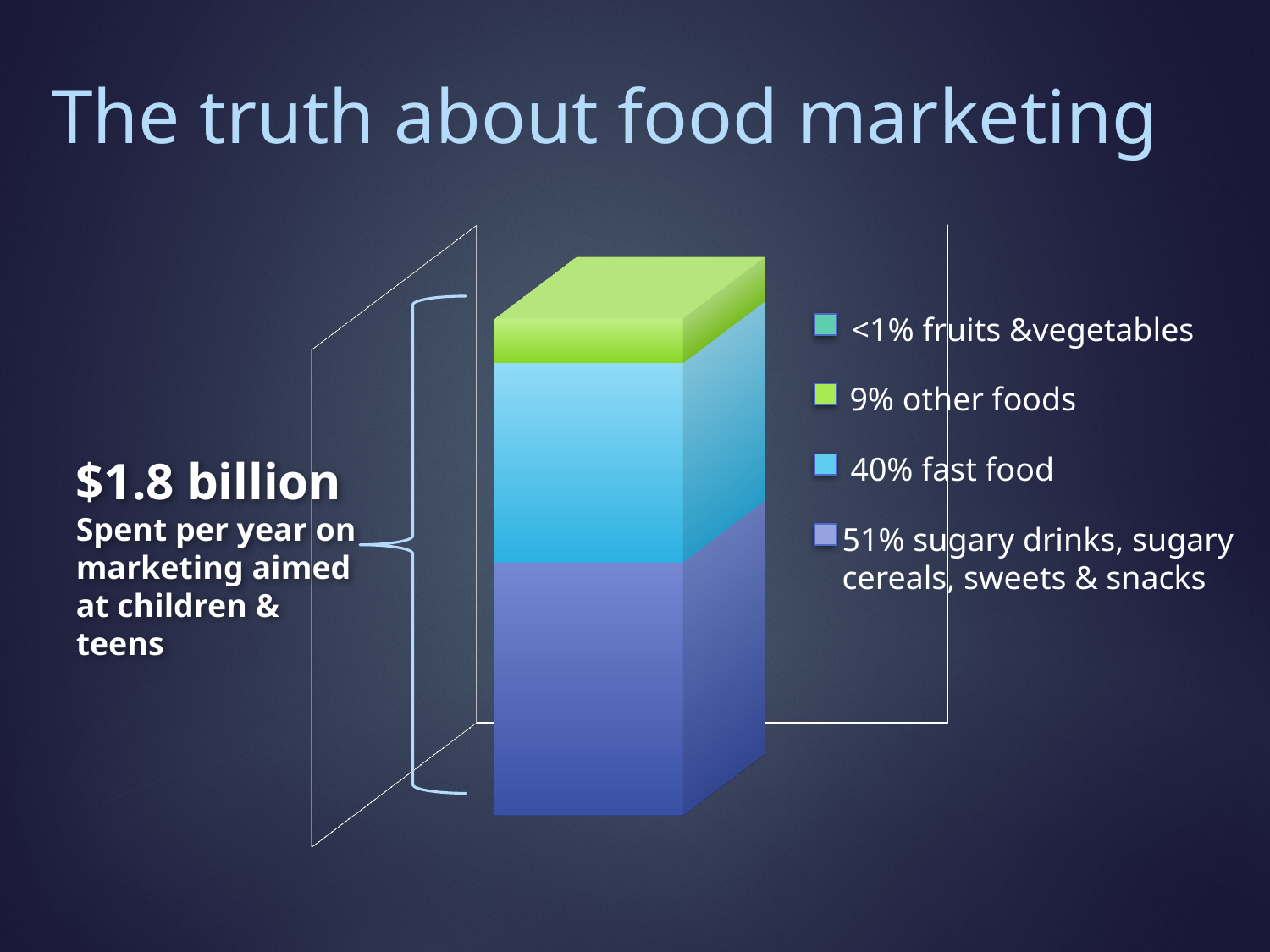
What is the title of the slide containing the chart? The truth about food marketing What percentage does the legend give for other foods? 9% What is the difference between the percentage for sugary drinks, sugary cereals, sweets & snacks and the percentage for fast food? 11% What percentage does the legend give for fast food? 40% Which category has the largest share of the stacked bar? Sugary drinks, sugary cereals, sweets & snacks What percentage does the legend give for fruits & vegetables? <1% Which is larger, the share for fast food or the share for other foods? Fast food What kind of chart is shown on the slide? Stacked bar chart How many series does the legend list? 4 What percentage does the legend give for sugary drinks, sugary cereals, sweets & snacks? 51% Which category has the smallest share of the stacked bar? Fruits & vegetables What total amount of spending does the stacked bar represent, according to the text on the left? $1.8 billion